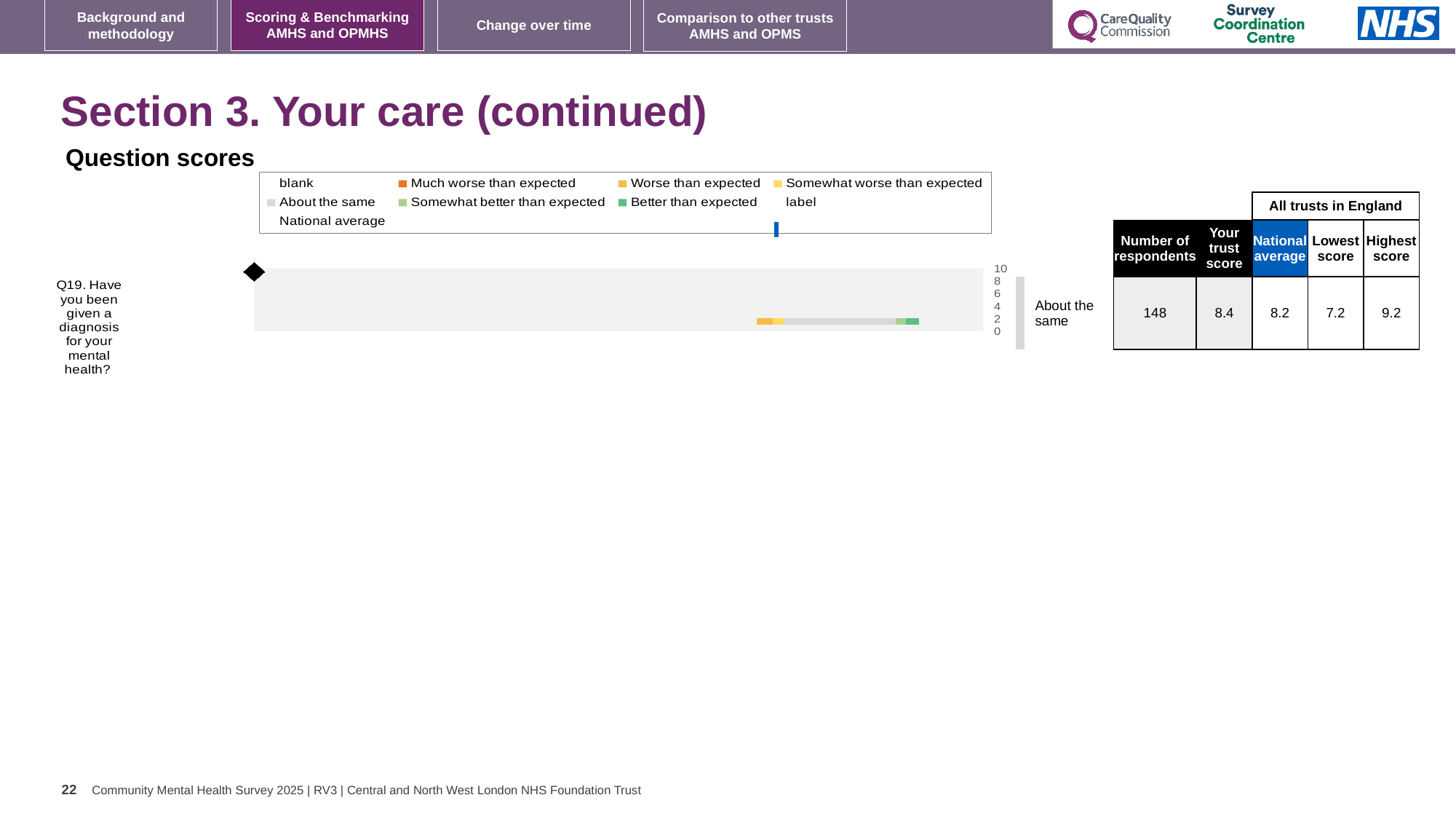
Which question is plotted in the Question scores chart? Q19. Have you been given a diagnosis for your mental health? What is the lowest score among all trusts in England for Q19? 7.2 By how much does the trust score for Q19 exceed the national average? 0.2 What is the highest score among all trusts in England for Q19? 9.2 What is the benchmark category shown for Q19? About the same How many questions are plotted in the Question scores chart? 1 How many respondents answered Q19? 148 What kind of chart is shown under 'Question scores'? bar chart Which is higher for Q19, the trust score or the national average? the trust score What is the difference between the highest and lowest scores for Q19? 2.0 What is the national average for Q19? 8.2 What is the trust score for Q19? 8.4